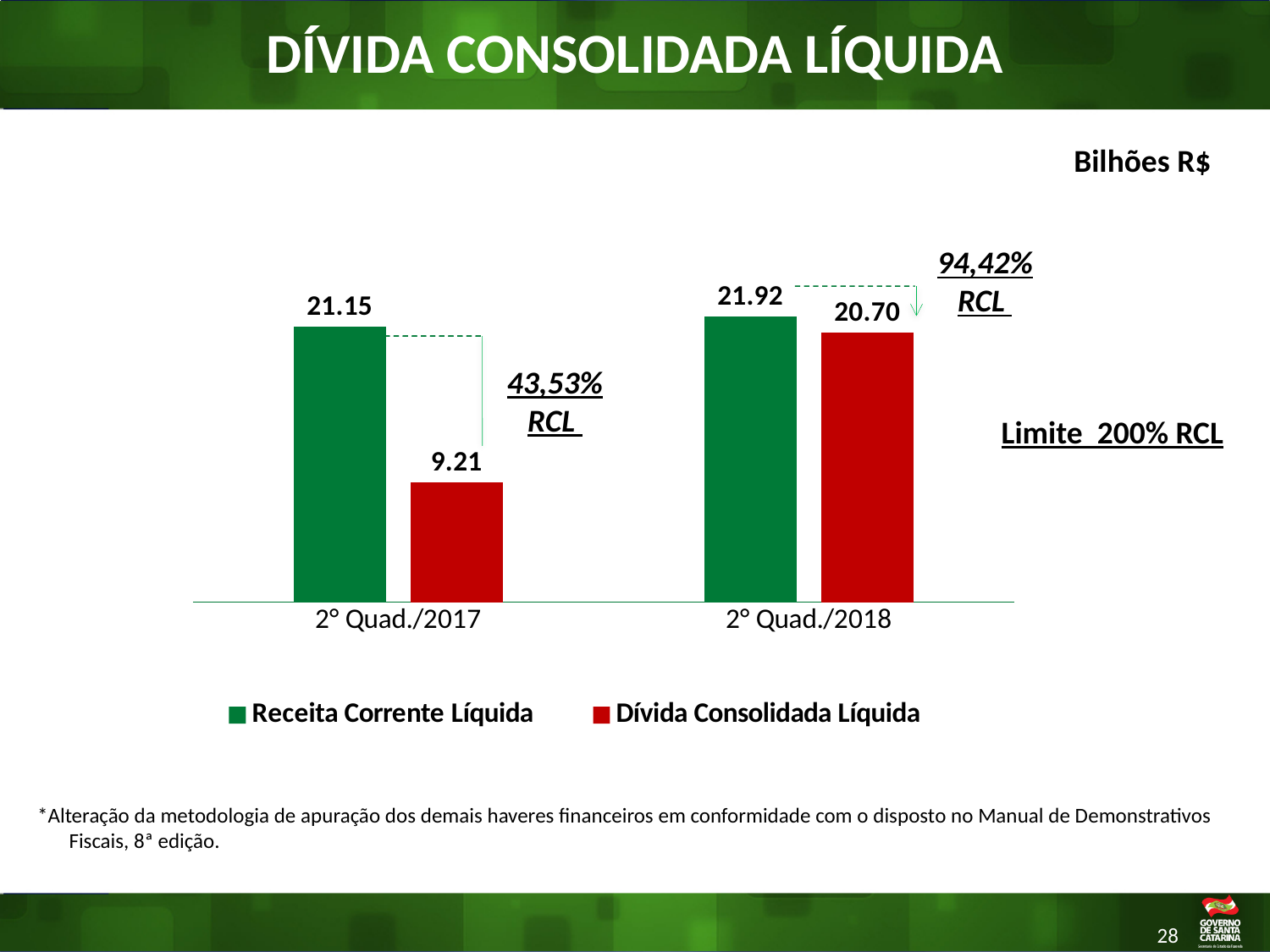
Is Receita Corrente Líquida or Dívida Consolidada Líquida larger in 2° Quad./2018? Receita Corrente Líquida What is the value of Receita Corrente Líquida for 2° Quad./2017? 21.15 What percentage of RCL is shown for 2° Quad./2018? 94,42% What is the value of Dívida Consolidada Líquida for 2° Quad./2017? 9.21 How many series does the legend list? 2 Which period has the higher Dívida Consolidada Líquida? 2° Quad./2018 What is the value of Dívida Consolidada Líquida for 2° Quad./2018? 20.70 What is the difference between Dívida Consolidada Líquida in 2° Quad./2018 and 2° Quad./2017? 11.49 Which period has the lower Dívida Consolidada Líquida? 2° Quad./2017 What is the difference between Receita Corrente Líquida and Dívida Consolidada Líquida in 2° Quad./2017? 11.94 What is the value of Receita Corrente Líquida for 2° Quad./2018? 21.92 What kind of chart is shown on the slide? Bar chart